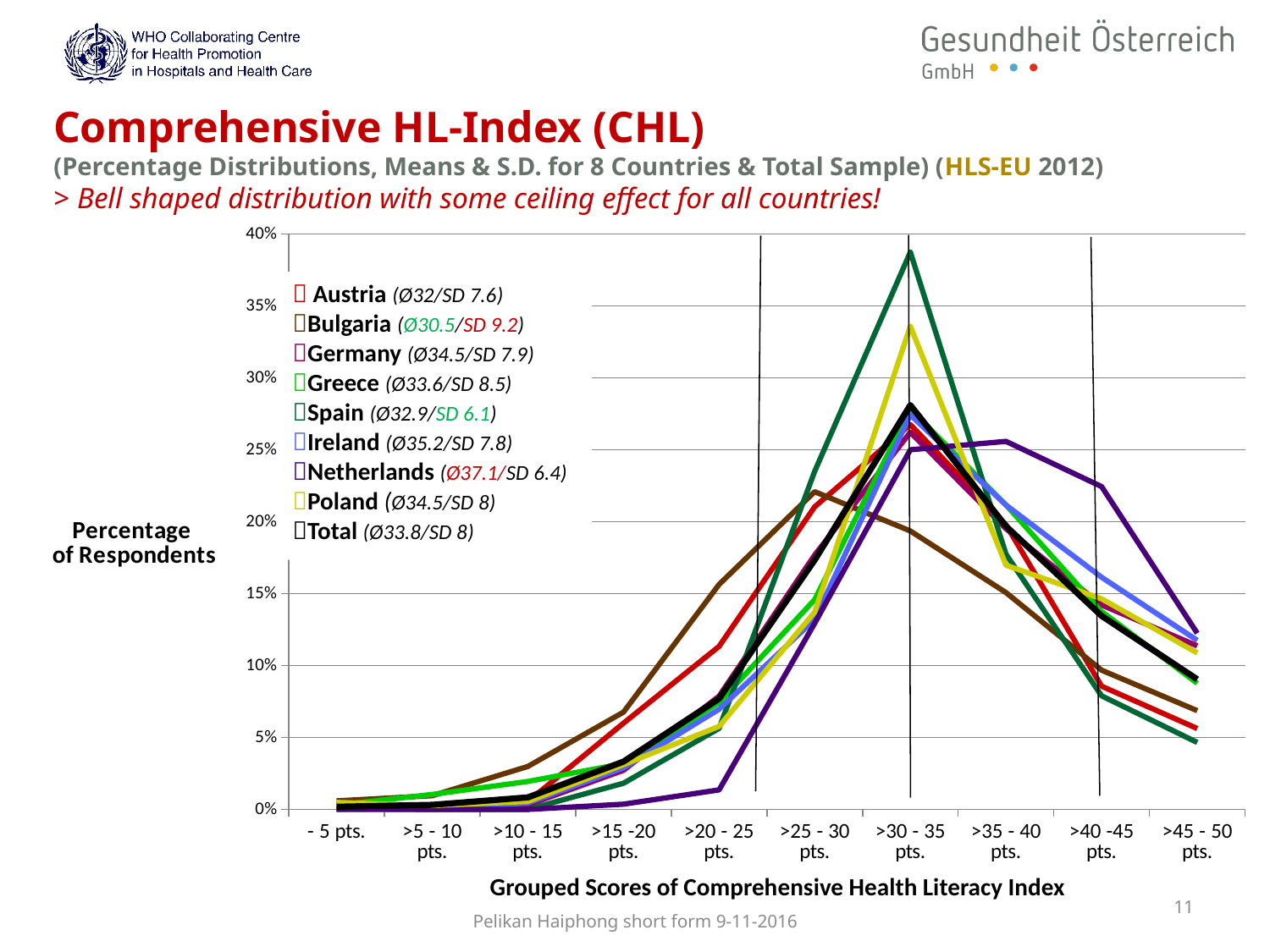
Do the values for Bulgaria rise or fall from the >30 - 35 pts. category to the >45 - 50 pts. category? fall What kind of chart is shown on the slide? line chart According to the legend, what mean and standard deviation are given for the Netherlands? Ø37.1/SD 6.4 Is the value for Spain in the >30 - 35 pts. category greater or less than 35%? greater How many series does the legend list? 9 How many grouped score categories are shown along the x axis? 10 Is the value for Netherlands in the >20 - 25 pts. category greater or less than 5%? less Which series has the lowest value in the >20 - 25 pts. category? Netherlands Is the value for Bulgaria in the >25 - 30 pts. category greater or less than 20%? greater In the >30 - 35 pts. category, which is larger: the value for Spain or the value for Netherlands? Spain Which series has the highest value in the >30 - 35 pts. category? Spain